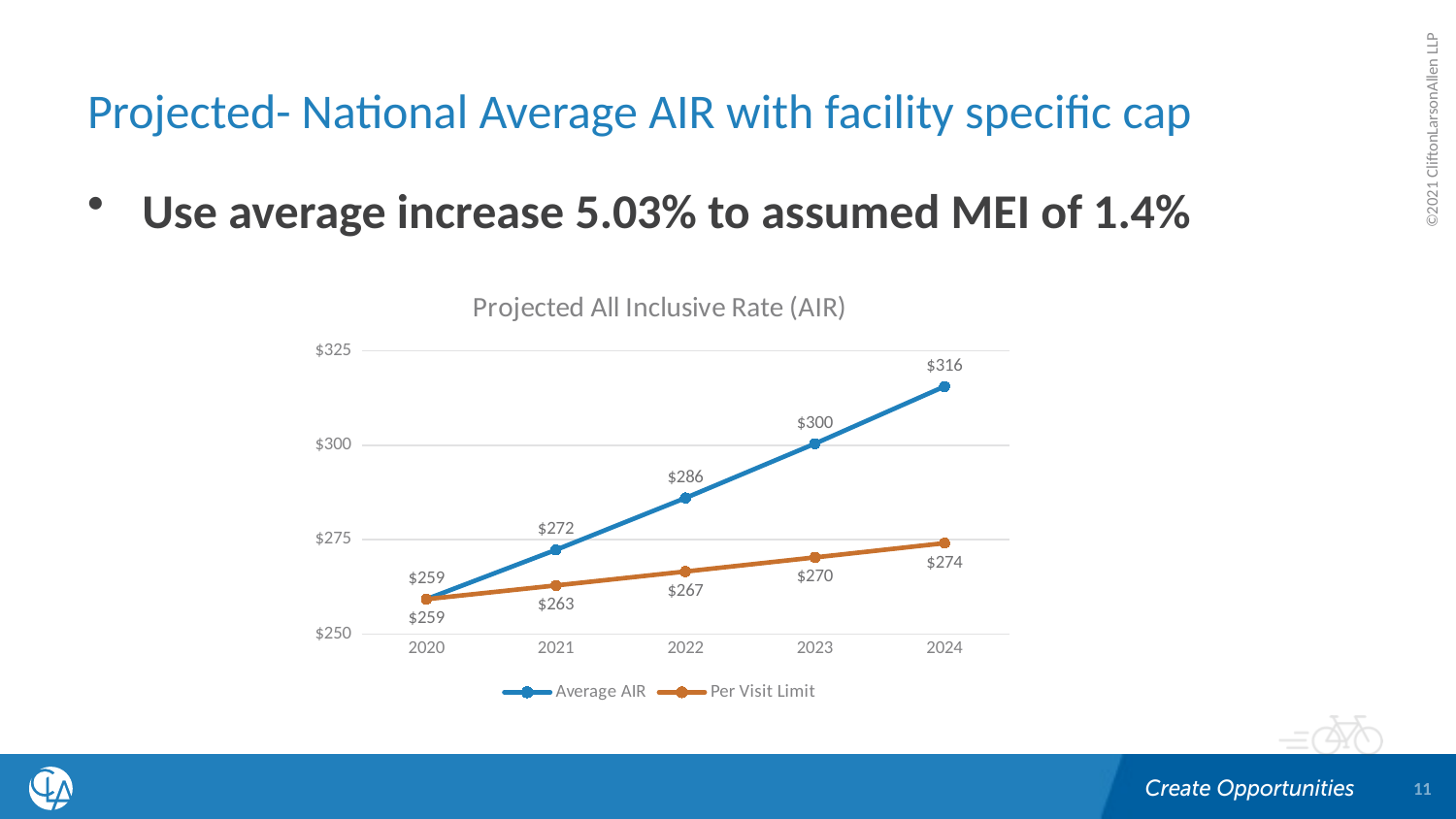
In which year is the Per Visit Limit lowest? 2020 Which is larger in 2022, the Average AIR or the Per Visit Limit? Average AIR What kind of chart is shown on the slide? line chart How many years are shown on the x axis? 5 How many series does the legend list? 2 Is the Average AIR value for 2023 greater or less than $275? greater What is the Average AIR value for 2021? $272 What is the Per Visit Limit value for 2022? $267 What is the difference between the Average AIR and the Per Visit Limit in 2023? $30 What is the title of the chart? Projected All Inclusive Rate (AIR) In which year is the Average AIR highest? 2024 What is the Average AIR value for 2024? $316